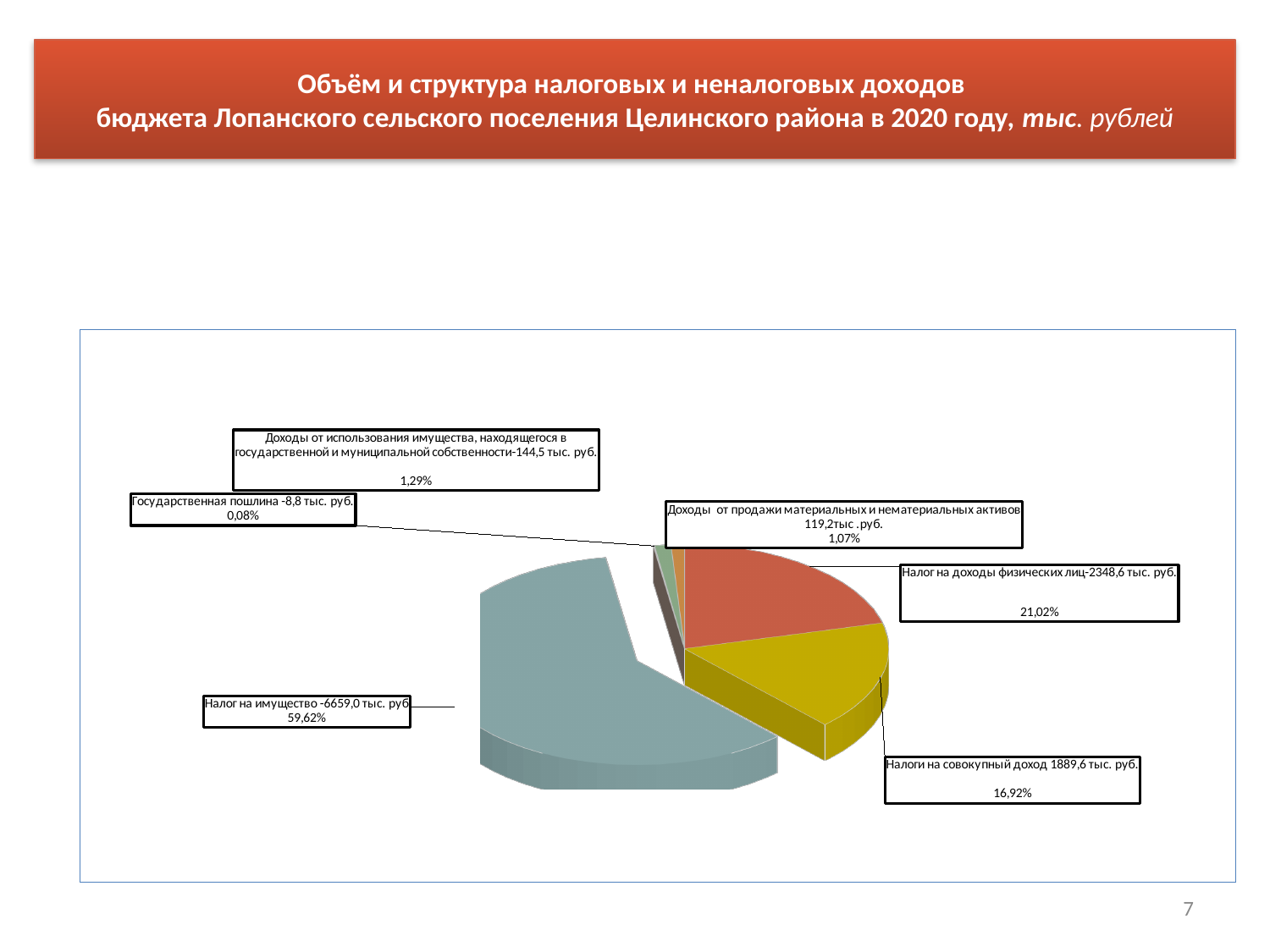
What is the value for Налог на имущество? 6659,0 тыс. руб. Which category has the smallest share of the pie? Государственная пошлина What type of chart is shown on the slide? pie chart What share of the pie does Налог на имущество represent? 59,62% Which is larger: Налог на доходы физических лиц or Налоги на совокупный доход? Налог на доходы физических лиц What is the value for Государственная пошлина? 8,8 тыс. руб. What is the difference between the values for Налог на доходы физических лиц and Налоги на совокупный доход? 459,0 тыс. руб. How many slices does the pie chart have? 6 Which category has the largest share of the pie? Налог на имущество What share of the pie does Доходы от продажи материальных и нематериальных активов represent? 1,07% What share of the pie does Налоги на совокупный доход represent? 16,92% What is the value for Налог на доходы физических лиц? 2348,6 тыс. руб.